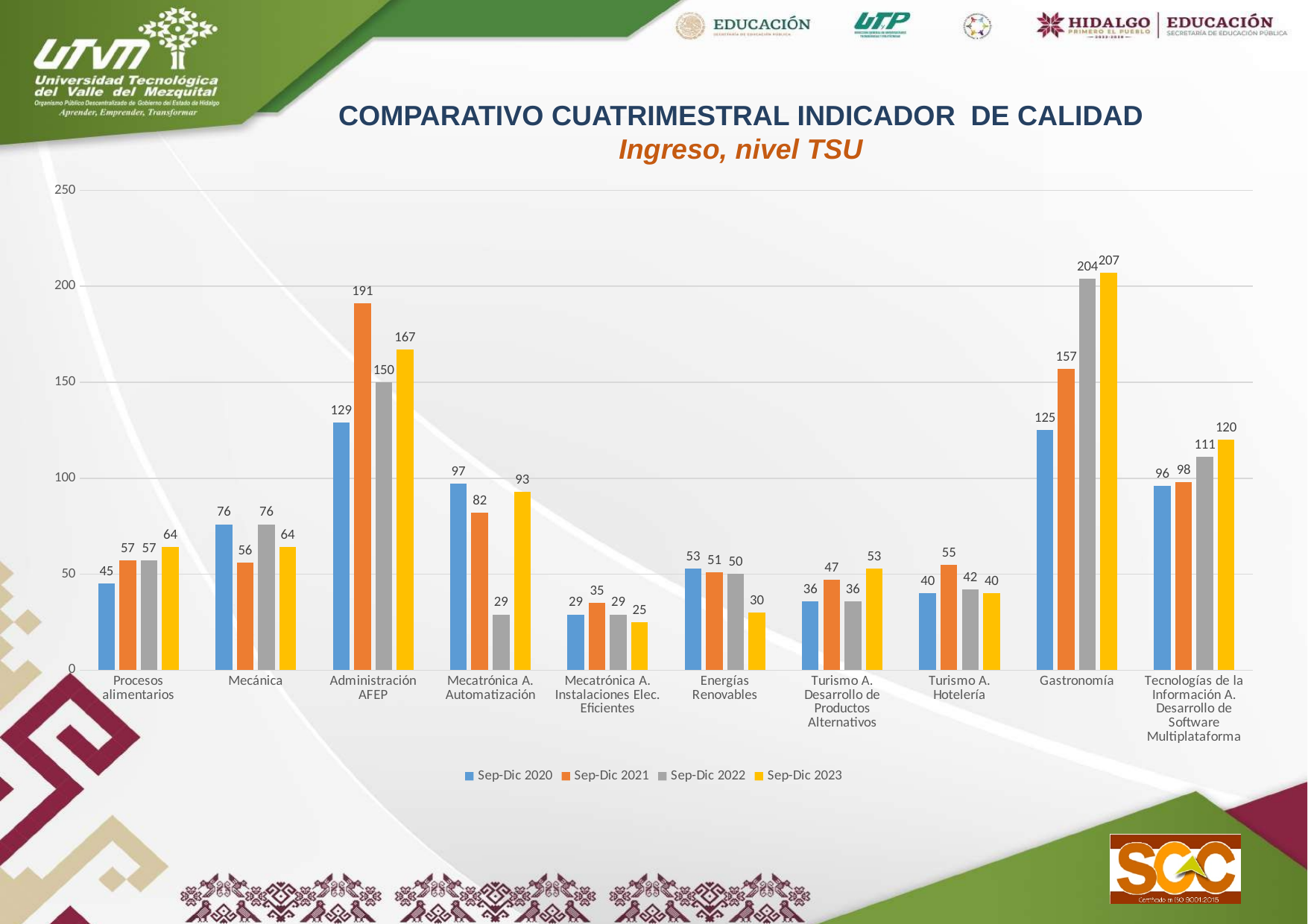
What is the value for Administración AFEP in Sep-Dic 2021? 191 How many series does the legend list? 4 Do the values for Tecnologías de la Información A. Desarrollo de Software Multiplataforma rise or fall from Sep-Dic 2020 to Sep-Dic 2023? rise Which category has the lowest value in Sep-Dic 2023? Mecatrónica A. Instalaciones Elec. Eficientes How many categories are shown on the x axis? 10 What is the value for Energías Renovables in Sep-Dic 2023? 30 What is the difference between the Sep-Dic 2021 and Sep-Dic 2020 values for Administración AFEP? 62 What kind of chart is shown on the slide? bar chart What is the value for Gastronomía in Sep-Dic 2023? 207 Which category has the highest value in Sep-Dic 2022? Gastronomía What is the subtitle of the chart shown in orange italics? Ingreso, nivel TSU Which is larger for Mecatrónica A. Automatización: the Sep-Dic 2020 value or the Sep-Dic 2022 value? Sep-Dic 2020